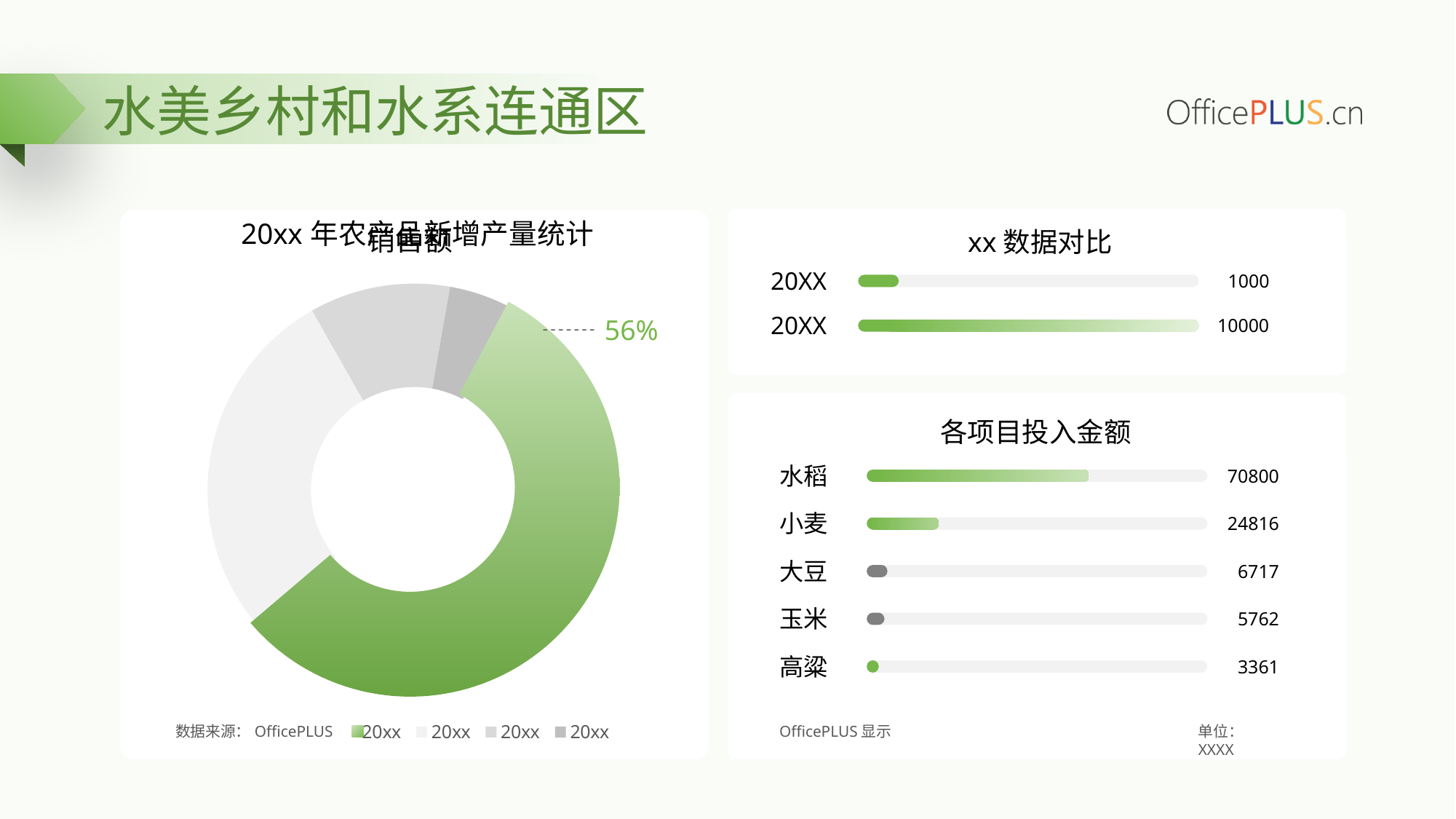
In the chart titled 各项目投入金额, what is the value for 高粱? 3361 In the chart titled 各项目投入金额, what is the value for 小麦? 24816 In the chart titled xx 数据对比, what is the value of the bottom bar? 10000 What kind of chart is the one titled 各项目投入金额? bar chart In the chart titled 各项目投入金额, which is larger, the value for 小麦 or the value for 大豆? 小麦 In the chart titled xx 数据对比, what is the difference between the bottom bar and the top bar? 9000 In the chart titled 各项目投入金额, which category has the highest value? 水稻 In the chart titled 各项目投入金额, what is the difference between the values for 大豆 and 玉米? 955 In the chart titled 各项目投入金额, which category has the lowest value? 高粱 In the chart titled 各项目投入金额, what is the value for 水稻? 70800 How many categories are shown in the chart titled 各项目投入金额? 5 In the donut chart on the left, what share is shown for the green slice? 56%